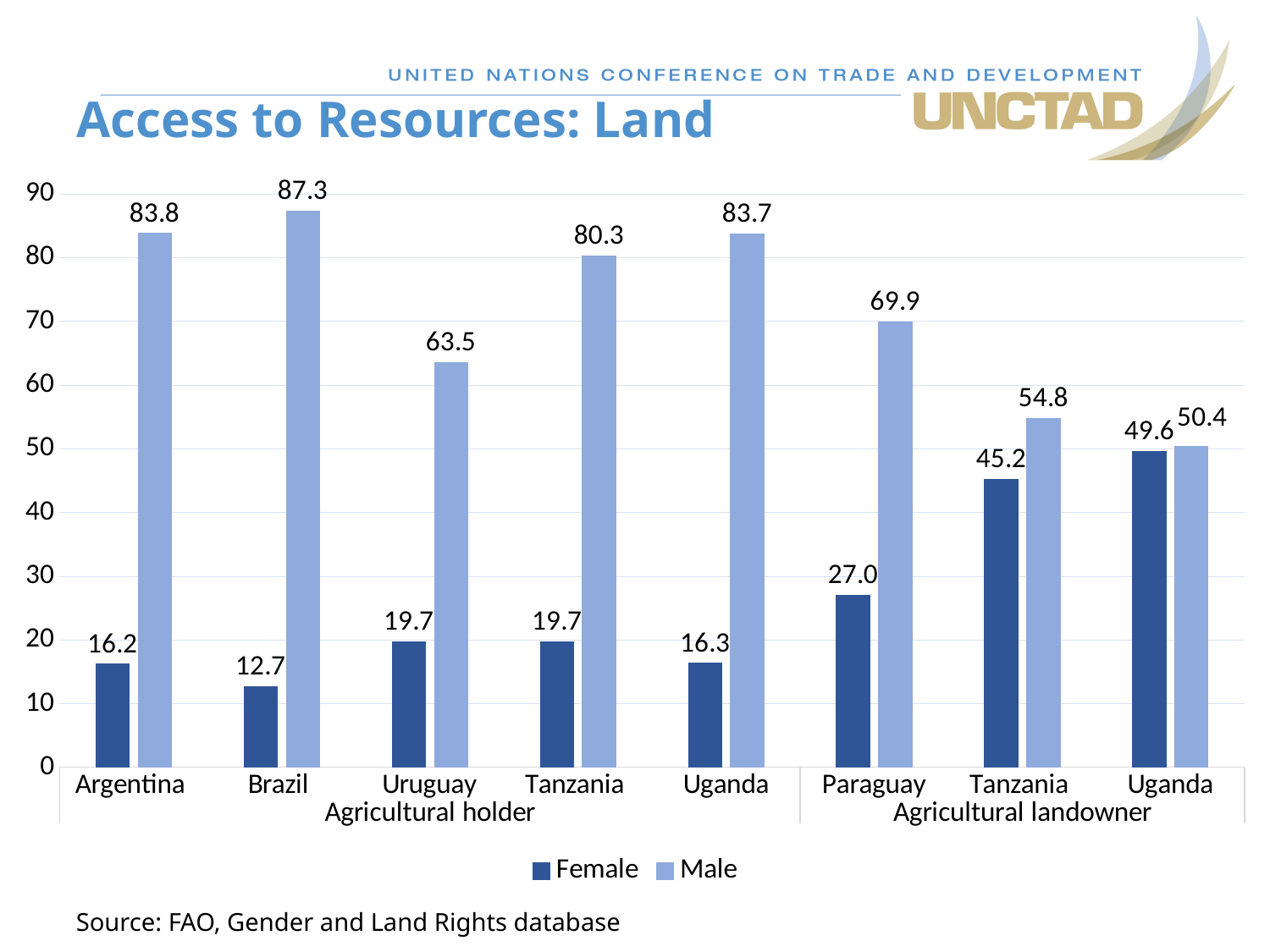
How many categories are shown on the x axis? 8 What is the difference between the Male and Female values for Argentina? 67.6 How many series does the legend list? 2 What kind of chart is shown on the slide? Bar chart Which category has the lowest Female value? Brazil What is the Male value for Paraguay under Agricultural landowner? 69.9 Which category has the highest Male value? Brazil What is the difference between the Male and Female values for Uganda under Agricultural landowner? 0.8 What is the Female value for Brazil under Agricultural holder? 12.7 What is the title of the slide? Access to Resources: Land Which is larger, the Male value for Uruguay or the Male value for Paraguay? Paraguay What is the Female value for Tanzania under Agricultural landowner? 45.2